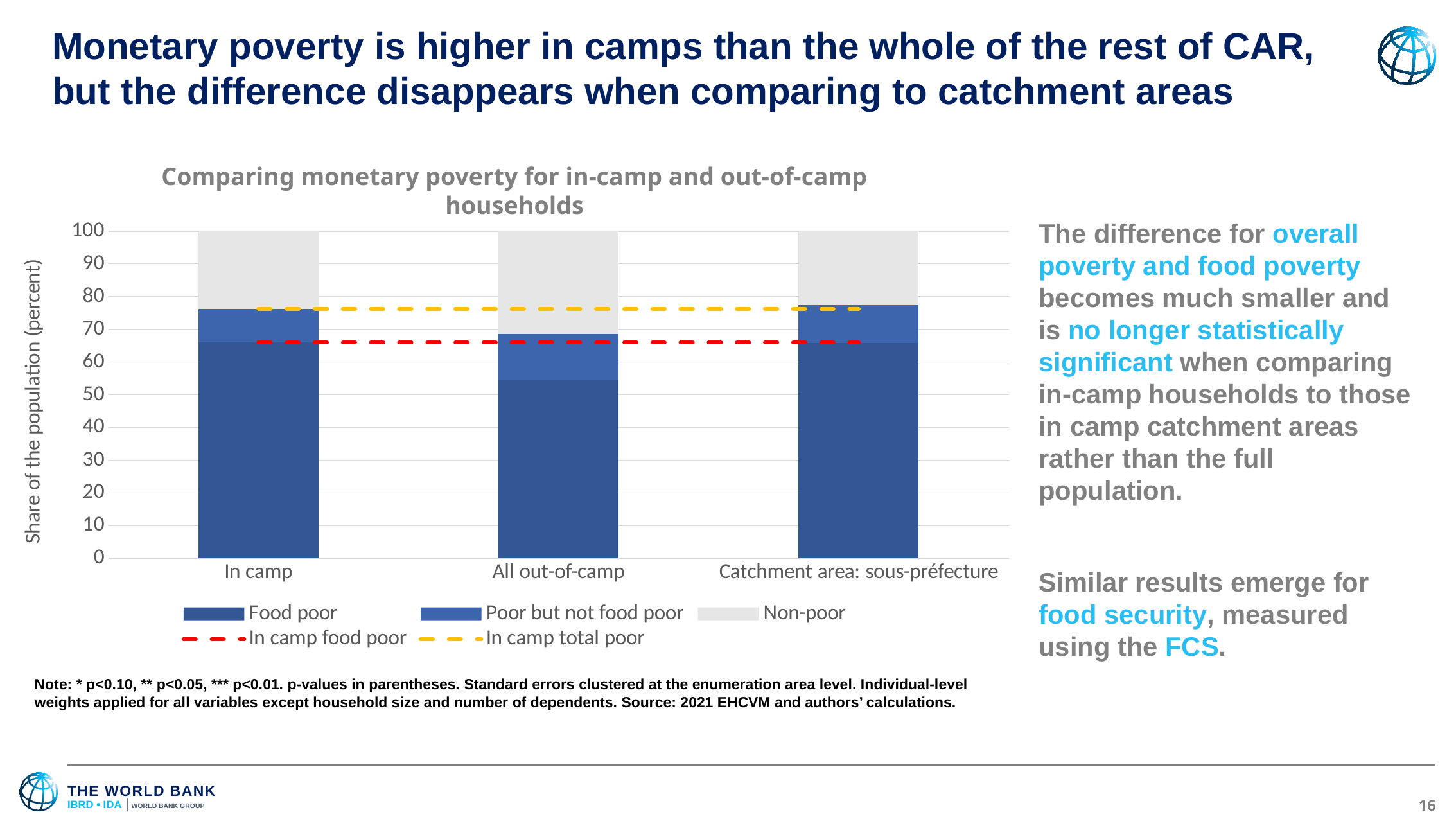
Which category has the lowest share of food poor? All out-of-camp What is the label of the y axis of the chart? Share of the population (percent) Is the combined share of food poor and poor but not food poor for Catchment area: sous-préfecture greater or less than 70? greater How many entries does the chart legend list? 5 How many categories are shown on the x axis of the chart? 3 Is the food poor share for In camp greater or less than 60? greater Is the combined share of food poor and poor but not food poor for In camp greater or less than 80? less What is the title of the chart? Comparing monetary poverty for in-camp and out-of-camp households What kind of chart is shown on the slide? Stacked bar chart Which has a larger food poor share, In camp or All out-of-camp? In camp Which category has the largest non-poor share? All out-of-camp